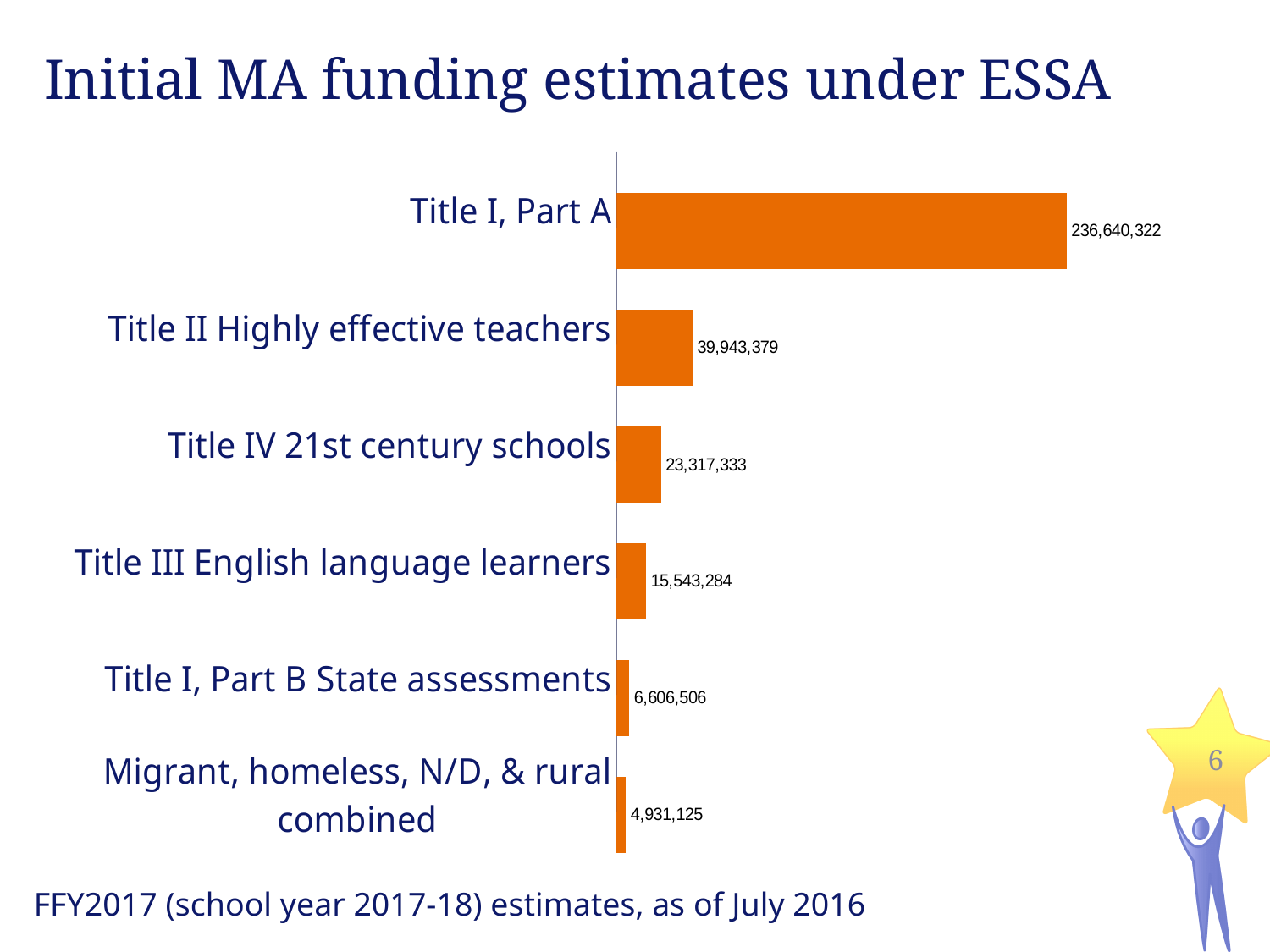
What is the funding estimate for Migrant, homeless, N/D, & rural combined? 4,931,125 What is the title of the slide containing the chart? Initial MA funding estimates under ESSA What kind of chart is shown on the slide? Bar chart What is the funding estimate for Title I, Part A? 236,640,322 Which category has the lowest funding estimate? Migrant, homeless, N/D, & rural combined What is the funding estimate for Title III English language learners? 15,543,284 How many categories are shown in the chart? 6 What is the difference between the funding estimates for Title IV 21st century schools and Title III English language learners? 7,774,049 Which category has the highest funding estimate? Title I, Part A What is the funding estimate for Title II Highly effective teachers? 39,943,379 What is the difference between the funding estimates for Title I, Part A and Title II Highly effective teachers? 196,696,943 Which has a larger funding estimate, Title I, Part B State assessments or Title IV 21st century schools? Title IV 21st century schools